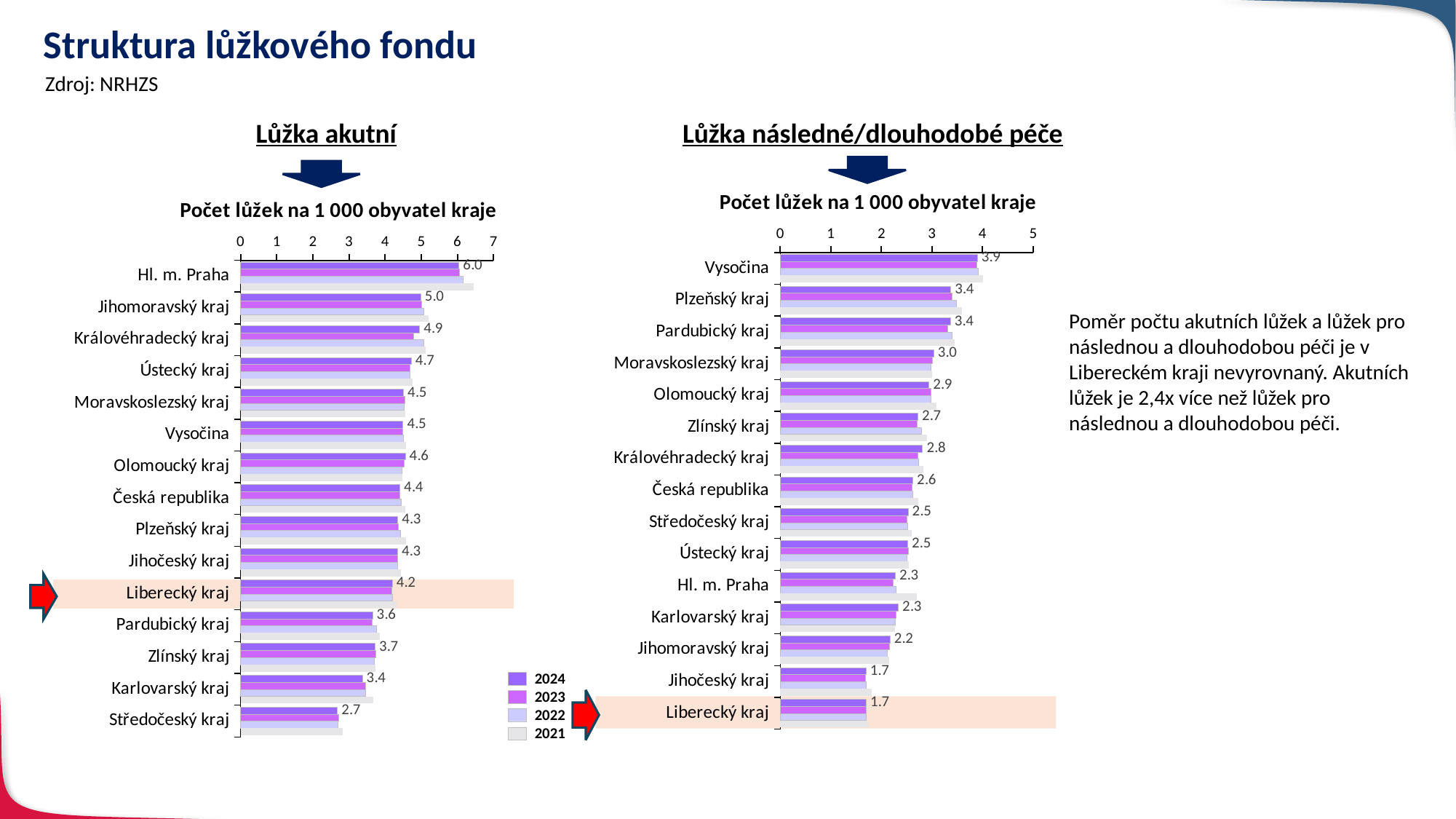
In the 'Lůžka akutní' chart, which region has the highest labelled value? Hl. m. Praha In the 'Lůžka akutní' chart, what is the labelled 2024 value for Liberecký kraj? 4.2 In the 'Lůžka akutní' chart, which region has the lowest labelled value? Středočeský kraj Which years are listed in the legend shared by the two charts? 2024, 2023, 2022, 2021 In the 'Lůžka následné/dlouhodobé péče' chart, what is the difference between the labelled values for Vysočina and Liberecký kraj? 2.2 What type of chart is 'Lůžka následné/dlouhodobé péče'? Bar chart In the 'Lůžka následné/dlouhodobé péče' chart, what is the labelled 2024 value for Vysočina? 3.9 In the 'Lůžka akutní' chart, which has the larger labelled value: Jihomoravský kraj or Karlovarský kraj? Jihomoravský kraj In the 'Lůžka akutní' chart, what is the labelled 2024 value for Česká republika? 4.4 How many regions (categories) are listed in the 'Lůžka akutní' chart? 15 In the 'Lůžka následné/dlouhodobé péče' chart, is the labelled value for Moravskoslezský kraj greater or less than 2? greater How many series does the legend list for the charts? 4